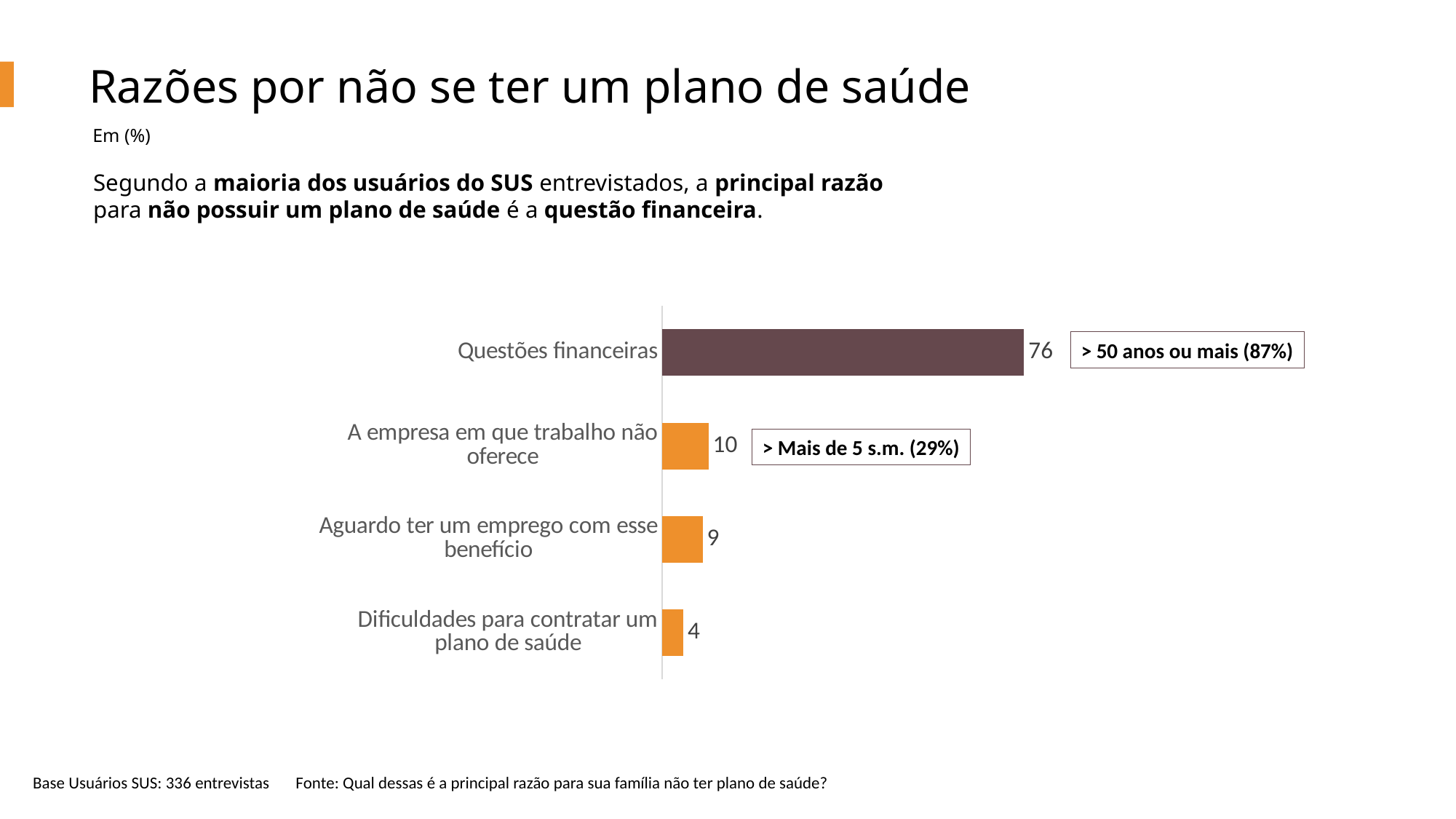
What is the value for "Dificuldades para contratar um plano de saúde"? 4 What is the value for "Questões financeiras"? 76 What is the value for "A empresa em que trabalho não oferece"? 10 What kind of chart is shown on the slide? Bar chart Which category has the highest value? Questões financeiras What is the difference between the values for "Aguardo ter um emprego com esse benefício" and "Dificuldades para contratar um plano de saúde"? 5 What is the difference between the values for "Questões financeiras" and "A empresa em que trabalho não oferece"? 66 How many categories are shown in the chart? 4 What is the value for "Aguardo ter um emprego com esse benefício"? 9 Which is larger: the value for "A empresa em que trabalho não oferece" or for "Dificuldades para contratar um plano de saúde"? A empresa em que trabalho não oferece What percentage is shown in the callout box next to the "Questões financeiras" bar for "50 anos ou mais"? 87% Which category has the lowest value? Dificuldades para contratar um plano de saúde